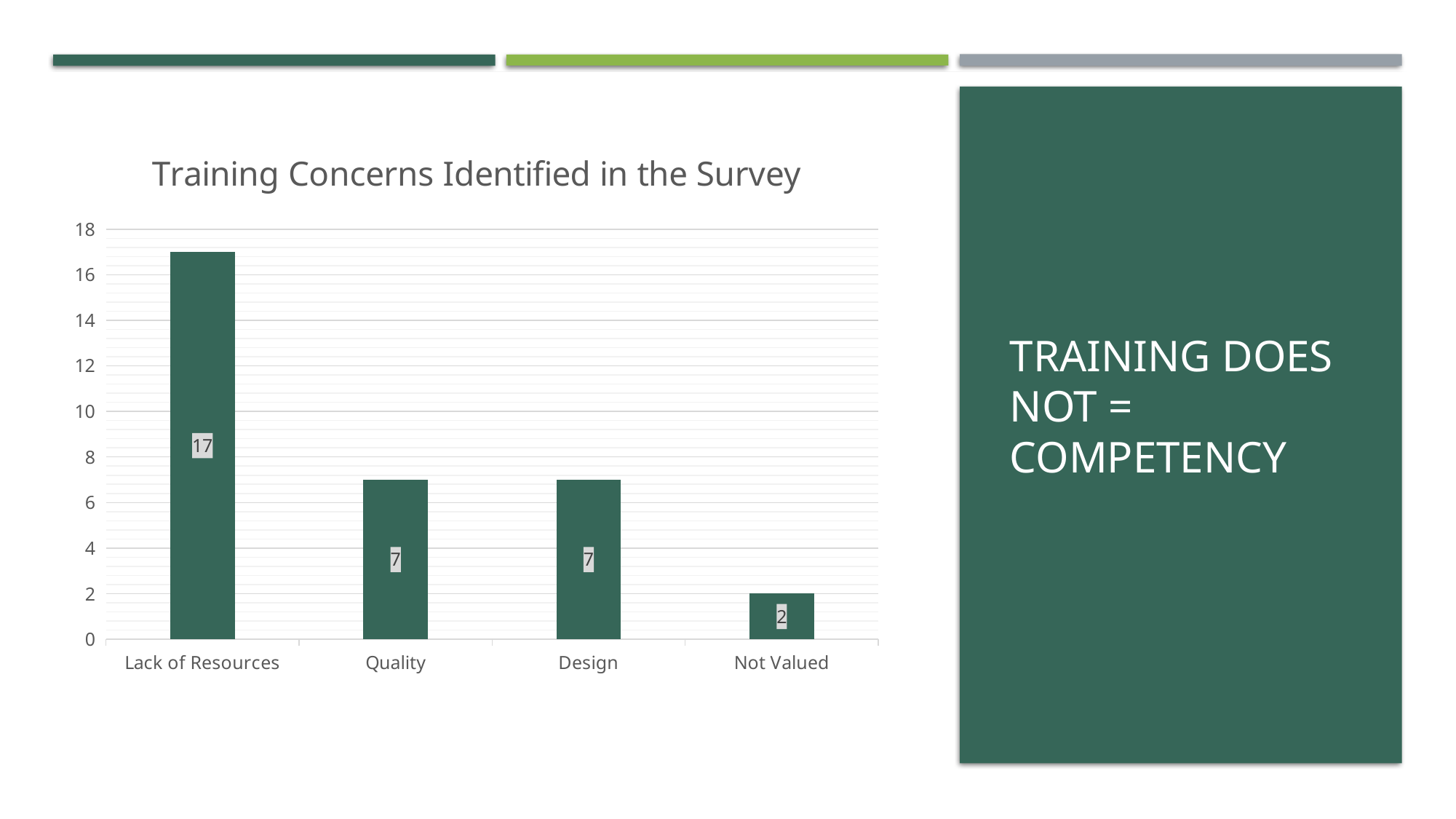
Is the value for Lack of Resources greater or less than 10? greater What is the difference between the values for Quality and Not Valued? 5 How many categories are shown on the x axis? 4 Which is larger, the value for Design or the value for Not Valued? Design Which category has the highest value? Lack of Resources What is the value for Quality? 7 What is the value for Lack of Resources? 17 What is the title of the chart? Training Concerns Identified in the Survey What kind of chart is shown on the slide? bar chart What is the value for Not Valued? 2 Which category has the lowest value? Not Valued What is the difference between the values for Lack of Resources and Design? 10